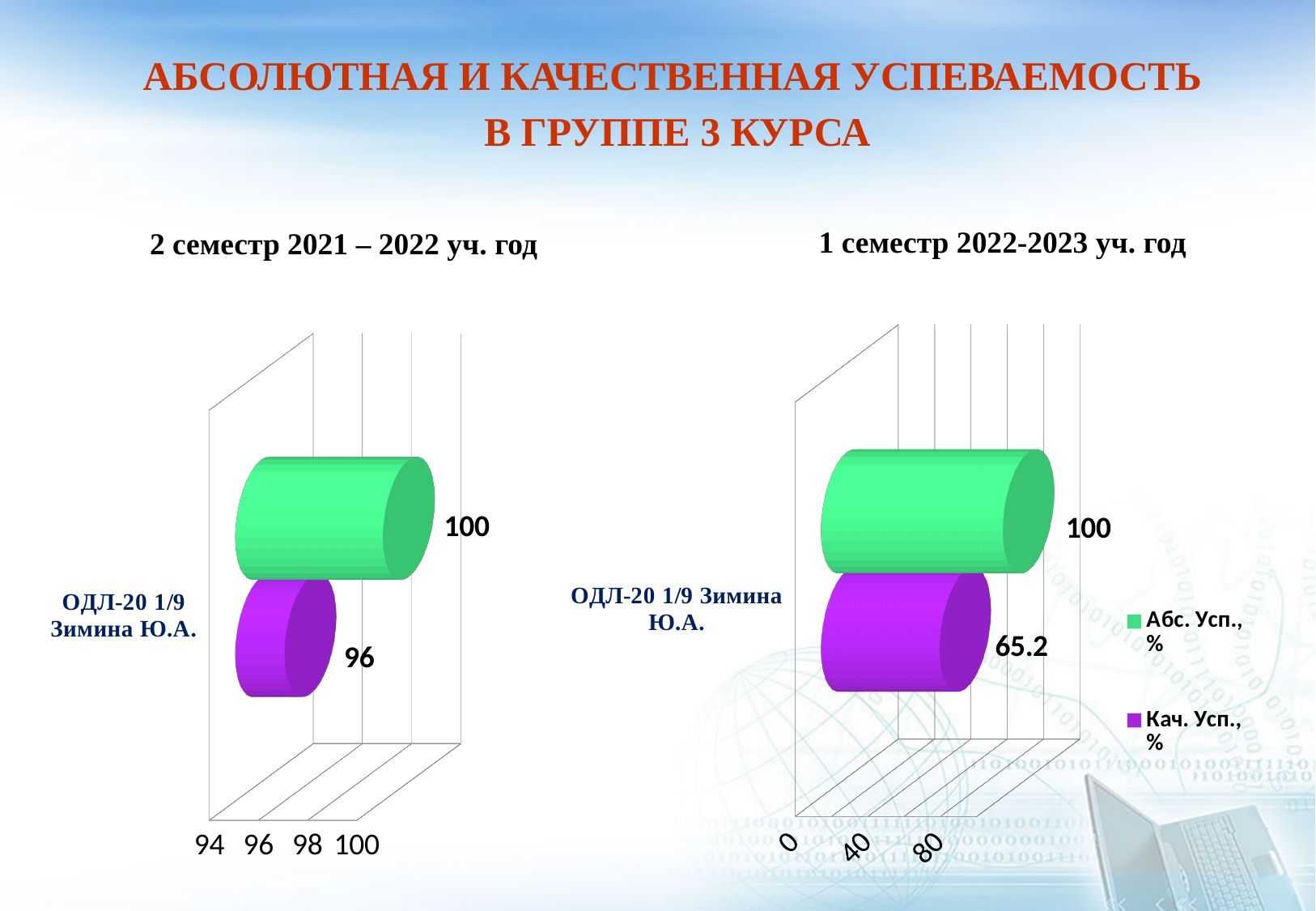
In the chart for 2 семестр 2021 – 2022 уч. год, what is the value of the purple bar (Кач. Усп., %)? 96 In the chart for 1 семестр 2022-2023 уч. год, is the value for Кач. Усп., % greater or less than 80? less How many series does the legend on the chart for 1 семестр 2022-2023 уч. год list? 2 What kind of chart is shown for 2 семестр 2021 – 2022 уч. год? bar chart In the chart for 2 семестр 2021 – 2022 уч. год, what is the difference between the green bar and the purple bar? 4 In the chart for 1 семестр 2022-2023 уч. год, which series has the lower value? Кач. Усп., % What is the category label shown on the chart for 1 семестр 2022-2023 уч. год? ОДЛ-20 1/9 Зимина Ю.А. In the chart for 2 семестр 2021 – 2022 уч. год, what is the value of the green bar (Абс. Усп., %)? 100 In the chart for 1 семестр 2022-2023 уч. год, which is larger: Абс. Усп., % or Кач. Усп., %? Абс. Усп., % In the chart for 1 семестр 2022-2023 уч. год, what is the value for Абс. Усп., %? 100 In the chart for 1 семестр 2022-2023 уч. год, what is the value for Кач. Усп., %? 65.2 In the chart for 1 семестр 2022-2023 уч. год, what is the difference between Абс. Усп., % and Кач. Усп., %? 34.8